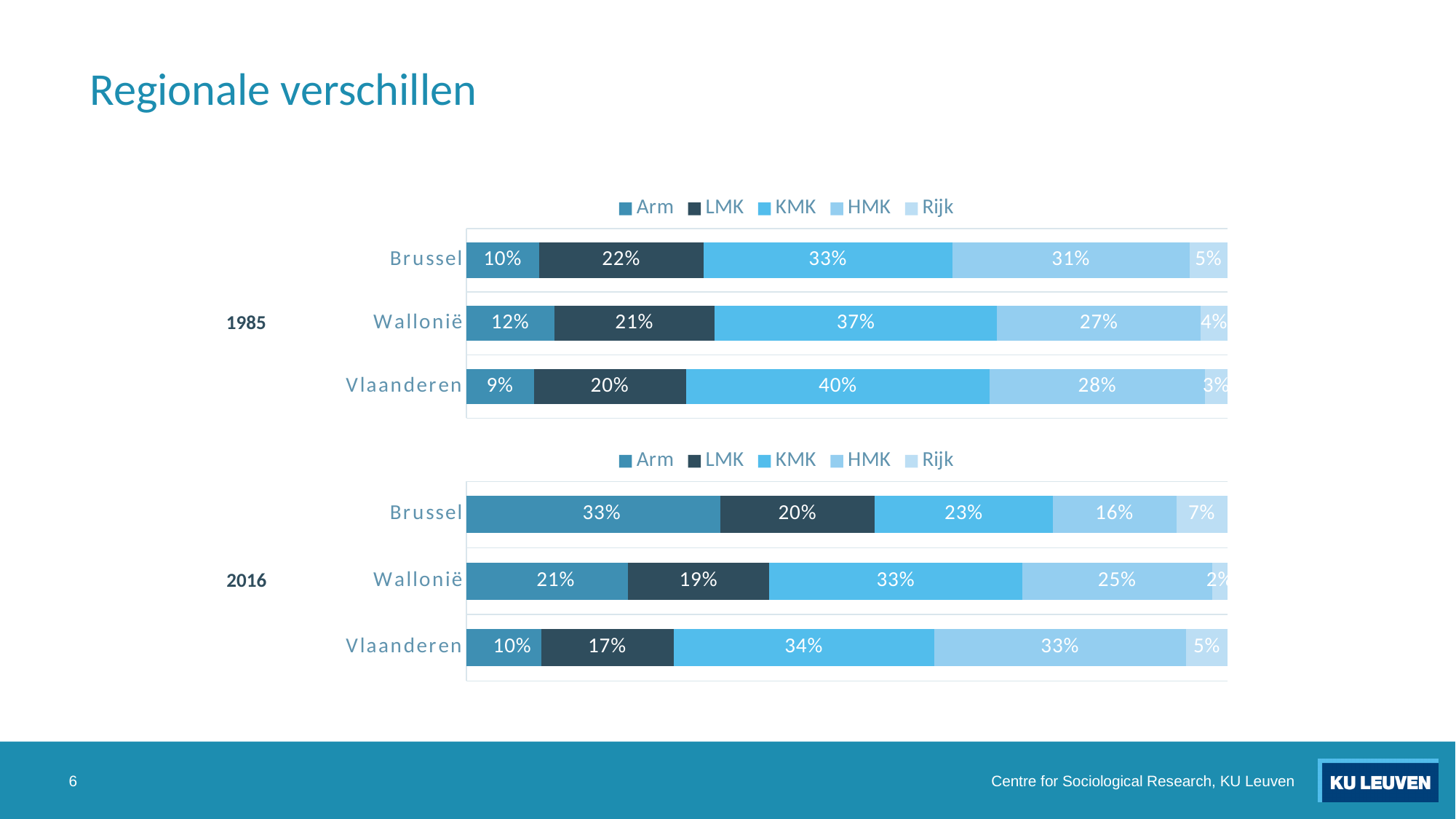
What kind of chart is the 1985 chart? Stacked bar chart In the 1985 chart, which is larger: the HMK value for Brussel or the HMK value for Wallonië? Brussel In the 1985 chart, what is the Rijk value for Wallonië? 4% In the 2016 chart, what is the difference between the Arm values for Brussel and Vlaanderen? 23% What is the title of the slide? Regionale verschillen How many series does the legend of the 1985 chart list? 5 In the 1985 chart, which region has the highest KMK value? Vlaanderen How many regions are shown in the 2016 chart? 3 In the 2016 chart, what is the HMK value for Wallonië? 25% In the 2016 chart, which region has the lowest Arm value? Vlaanderen In the 2016 chart, what is the Arm value for Brussel? 33% In the 1985 chart, what is the KMK value for Vlaanderen? 40%